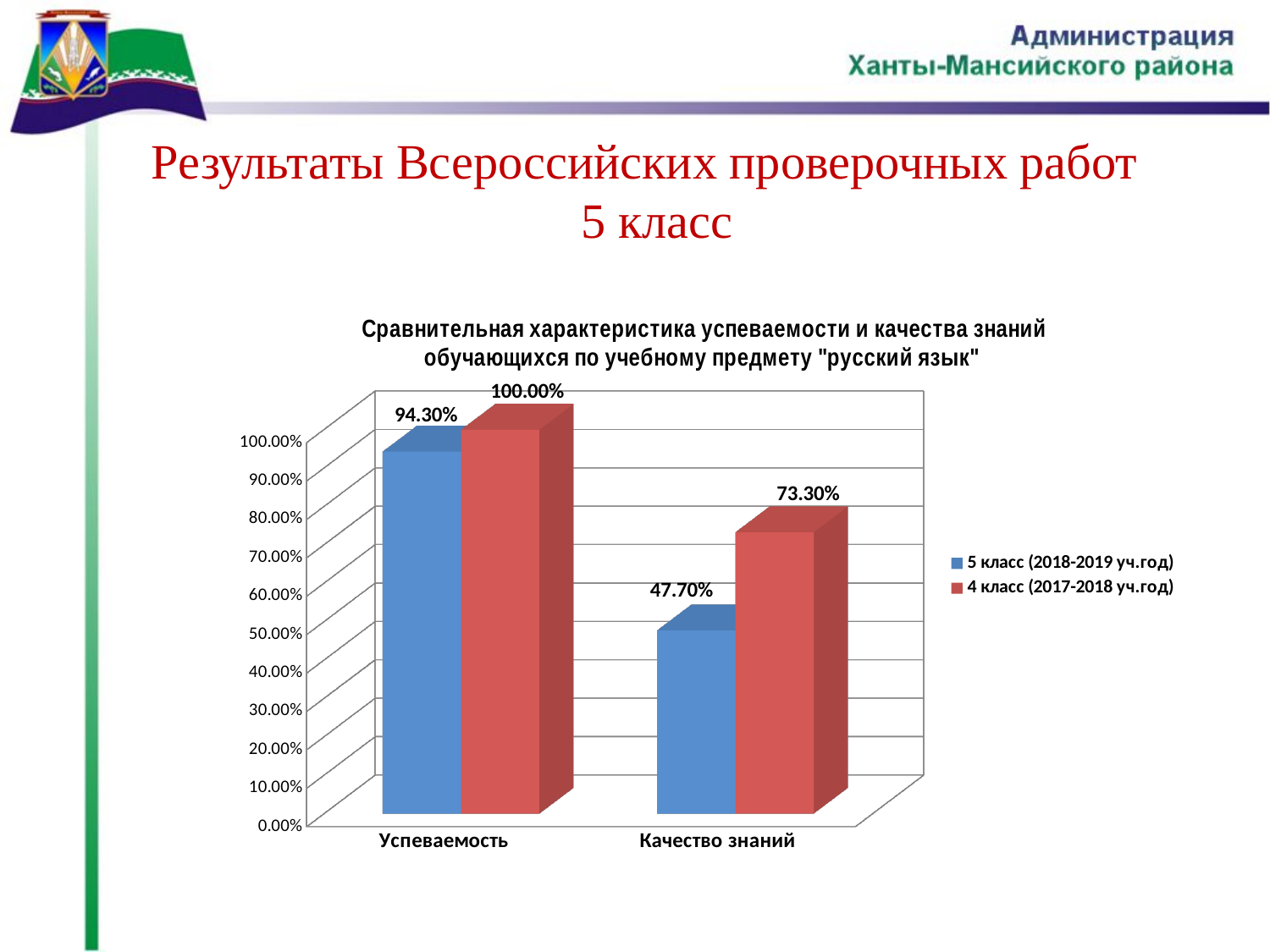
What is the difference between the 4 класс (2017-2018 уч.год) and 5 класс (2018-2019 уч.год) values for Успеваемость? 5.70% What is the value for Успеваемость in the 5 класс (2018-2019 уч.год) series? 94.30% How many series does the legend list? 2 What kind of chart is shown on the slide? Bar chart What is the value for Качество знаний in the 4 класс (2017-2018 уч.год) series? 73.30% Which series has the higher value for Качество знаний? 4 класс (2017-2018 уч.год) What is the difference between the 4 класс (2017-2018 уч.год) and 5 класс (2018-2019 уч.год) values for Качество знаний? 25.60% Which colour represents the 5 класс (2018-2019 уч.год) series? Blue Which category has the lowest value in the 5 класс (2018-2019 уч.год) series? Качество знаний What is the value for Успеваемость in the 4 класс (2017-2018 уч.год) series? 100.00% What is the value for Качество знаний in the 5 класс (2018-2019 уч.год) series? 47.70% How many categories are shown on the x axis? 2